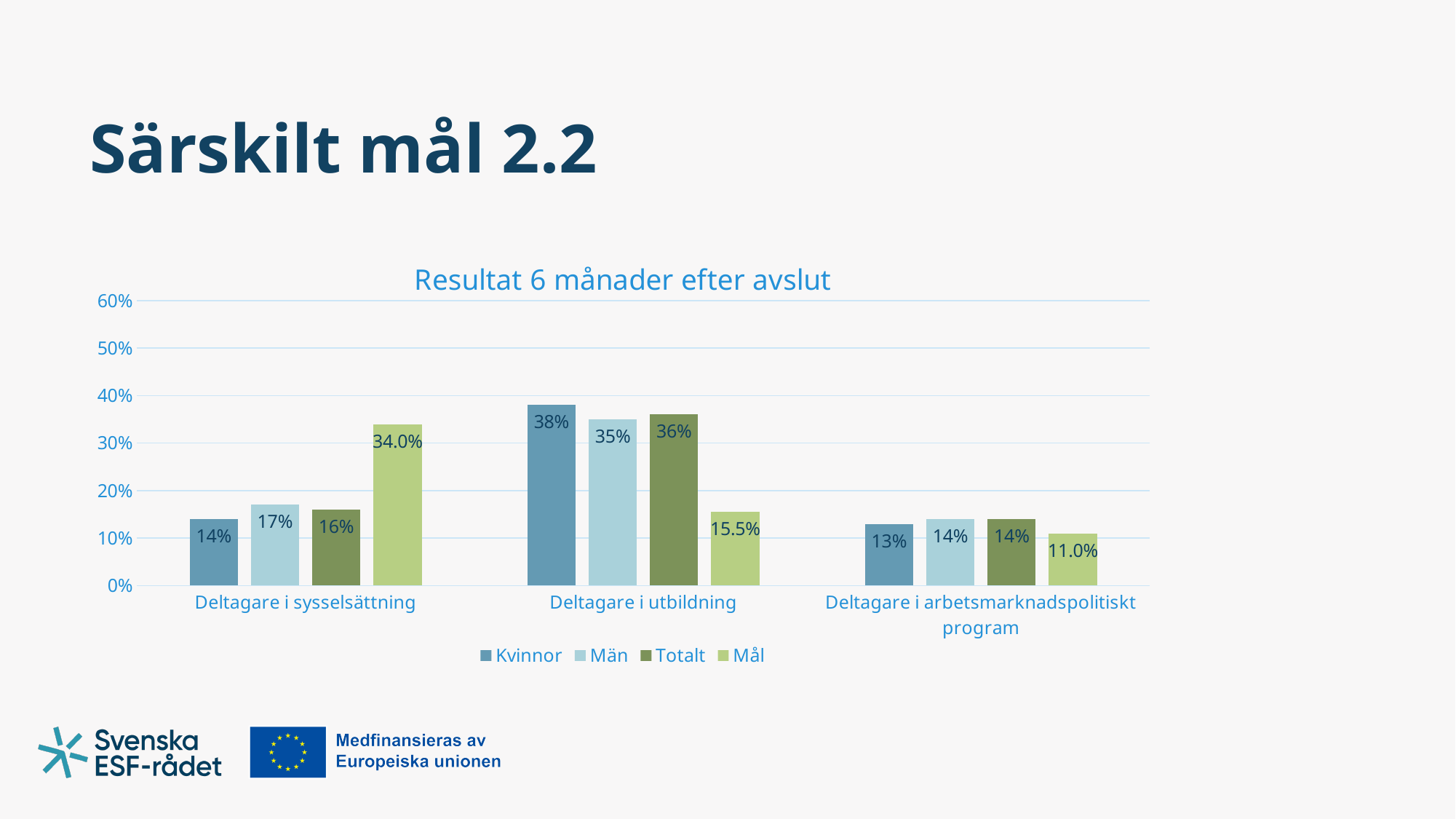
What kind of chart is shown on the slide? Bar chart Which category has the lowest Mål value? Deltagare i arbetsmarknadspolitiskt program What is the title of the chart? Resultat 6 månader efter avslut What is the Mål value for Deltagare i utbildning? 15.5% What is the difference between the Totalt value and the Mål value for Deltagare i sysselsättning? 18% What is the value for Kvinnor in the Deltagare i utbildning category? 38% How many series does the legend list? 4 How many categories are shown on the x axis? 3 Which category has the highest Kvinnor value? Deltagare i utbildning Which is larger for Deltagare i utbildning: the Kvinnor value or the Män value? Kvinnor What is the Totalt value for Deltagare i arbetsmarknadspolitiskt program? 14% What is the Mål value for Deltagare i sysselsättning? 34.0%